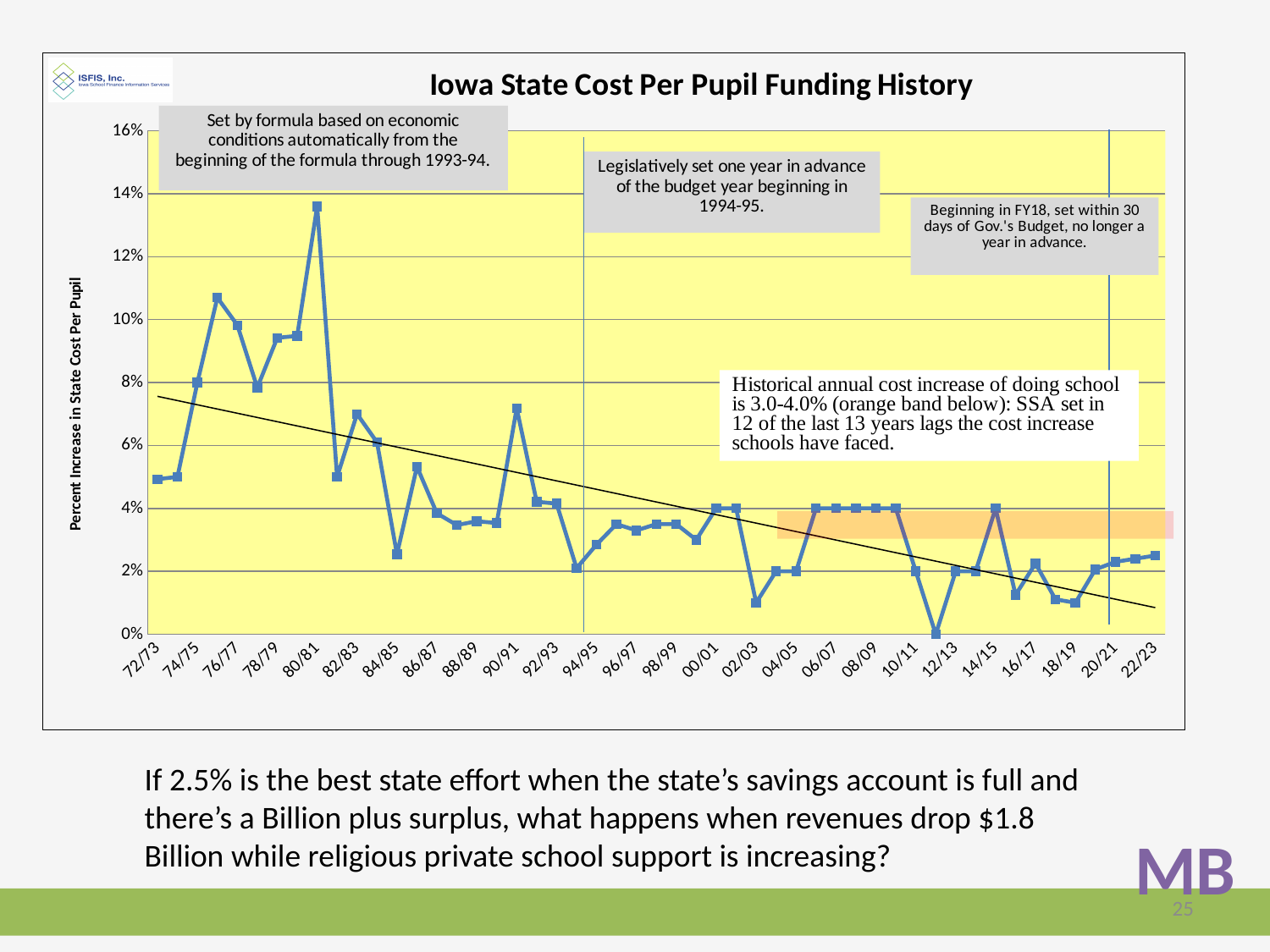
Which year has the highest percent increase in state cost per pupil? 80/81 What is the title of the chart? Iowa State Cost Per Pupil Funding History Is the value for 80/81 greater or less than 12%? greater What kind of chart is shown on the slide? Line chart What is the label on the vertical axis of the chart? Percent Increase in State Cost Per Pupil Which year has the larger percent increase, 80/81 or 75/76? 80/81 Which year has the lowest percent increase in state cost per pupil? 11/12 Is the value for 02/03 greater or less than 2%? less What is the percent increase in state cost per pupil for 11/12? 0% Is the value for 90/91 greater or less than 6%? greater Overall, do the percent increases rise or fall from 72/73 to 22/23? Fall